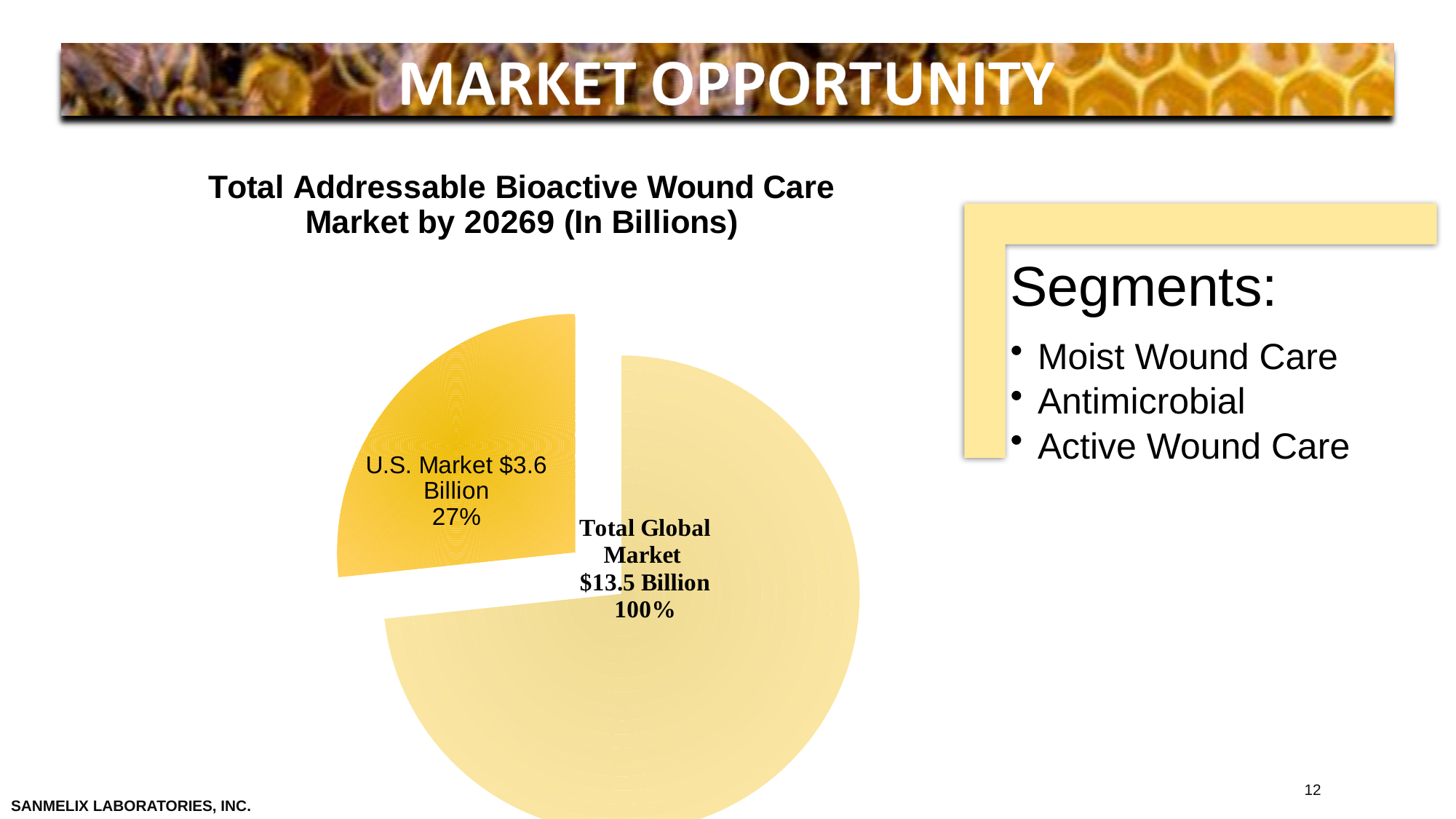
What percentage is shown for the U.S. Market slice? 27% What value is shown for the Total Global Market slice? $13.5 Billion Which slice is shown in the darker gold colour? U.S. Market How many slices does the pie chart have? 2 What is the difference between the Total Global Market value and the U.S. Market value? $9.9 Billion What is the title of the chart? Total Addressable Bioactive Wound Care Market by 20269 (In Billions) What value is shown for the U.S. Market slice? $3.6 Billion What percentage is shown for the Total Global Market slice? 100% Which slice of the pie chart is the largest? Total Global Market Which is larger, the U.S. Market value or the Total Global Market value? Total Global Market What type of chart is shown on the slide? Pie chart Which slice of the pie chart is the smallest? U.S. Market